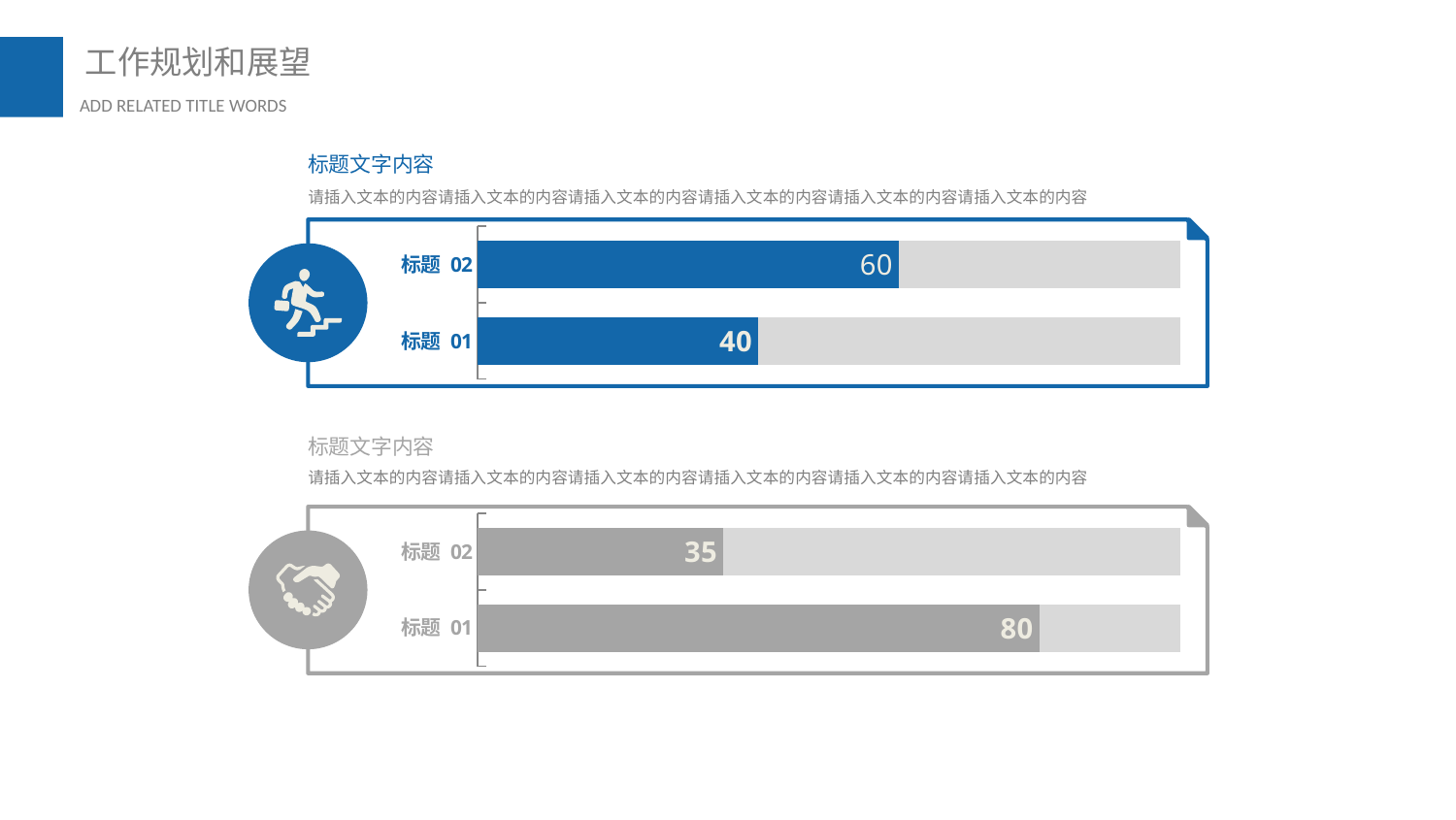
In the bottom chart, which is larger, the value for 标题 01 or 标题 02? 标题 01 In the bottom chart, what is the value for 标题 01? 80 In the top chart, what is the value for 标题 01? 40 How many categories does the top chart show? 2 What colour are the data bars in the top chart? blue In the top chart, what is the value for 标题 02? 60 In the top chart, what is the difference between the values for 标题 02 and 标题 01? 20 What kind of chart is the bottom chart? bar chart In the top chart, which category has the highest value? 标题 02 In the bottom chart, which category has the lowest value? 标题 02 In the bottom chart, what is the value for 标题 02? 35 In the bottom chart, what is the difference between the values for 标题 01 and 标题 02? 45